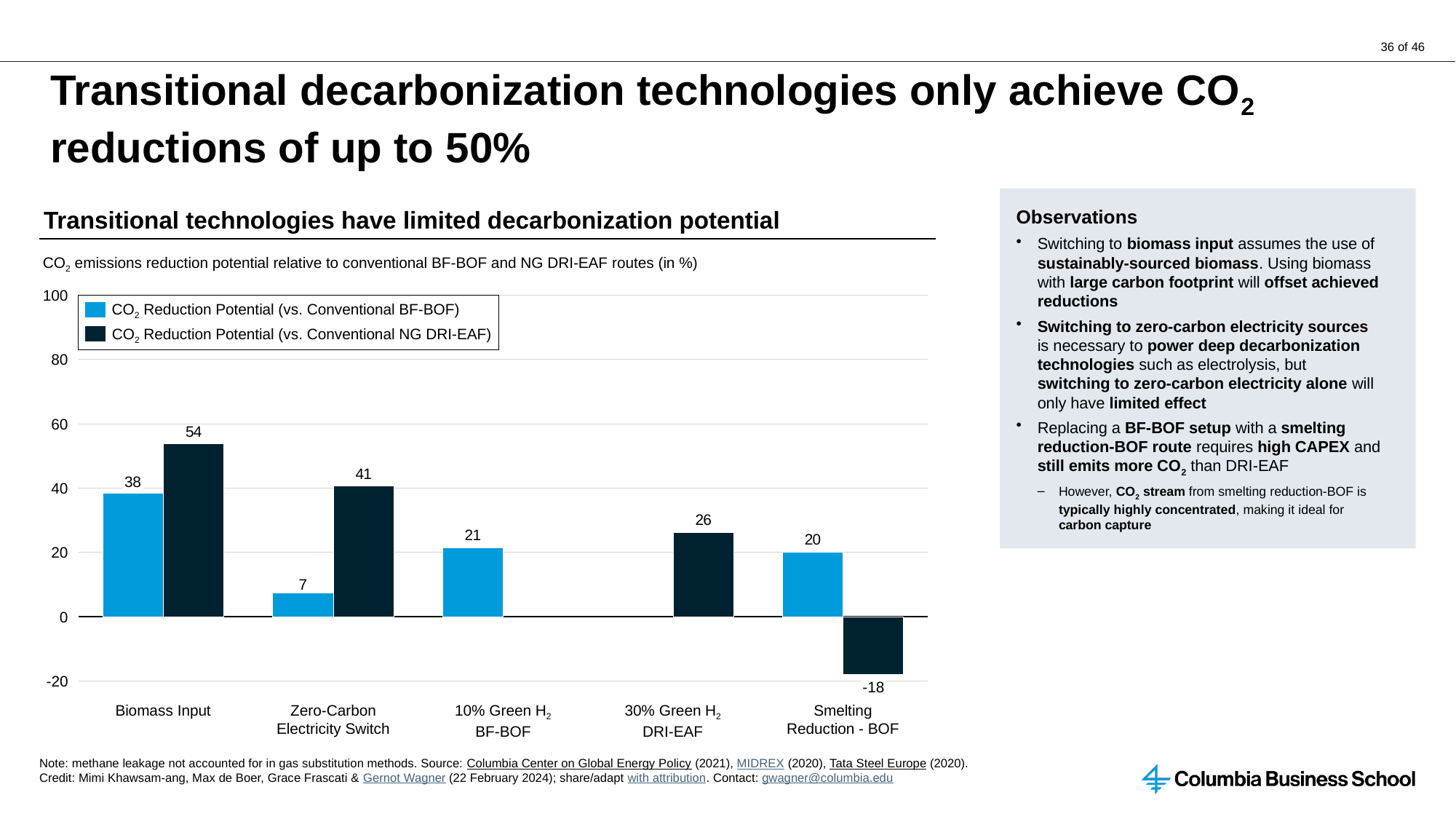
What is the CO2 Reduction Potential (vs. Conventional NG DRI-EAF) for Zero-Carbon Electricity Switch? 41 Which category has the highest CO2 Reduction Potential (vs. Conventional NG DRI-EAF)? Biomass Input Which category has the lowest CO2 Reduction Potential (vs. Conventional BF-BOF)? Zero-Carbon Electricity Switch What is the CO2 Reduction Potential (vs. Conventional NG DRI-EAF) for Smelting Reduction - BOF? -18 Is the CO2 Reduction Potential (vs. Conventional NG DRI-EAF) for Biomass Input greater or less than 40? greater How many categories are shown on the x axis of the chart? 5 What is the CO2 Reduction Potential (vs. Conventional BF-BOF) for Biomass Input? 38 What is the title of the chart? Transitional technologies have limited decarbonization potential Which is larger for Zero-Carbon Electricity Switch: the value vs. Conventional BF-BOF or the value vs. Conventional NG DRI-EAF? vs. Conventional NG DRI-EAF How many series does the chart legend list? 2 What kind of chart is shown on the slide? Bar chart What is the difference between the two series' values for Biomass Input? 16